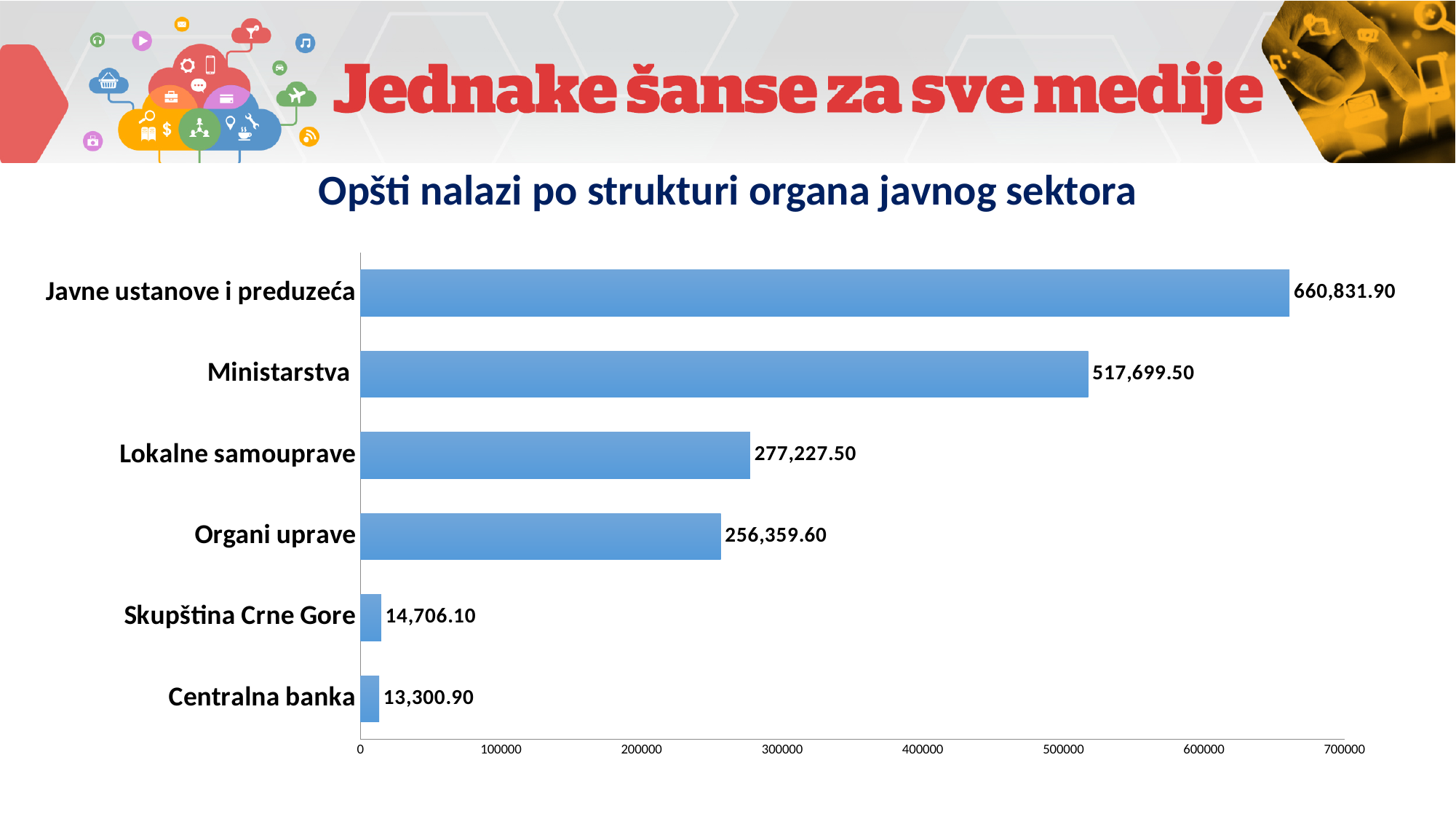
What is the value for Javne ustanove i preduzeća? 660,831.90 What is the value for Ministarstva? 517,699.50 Which has a larger value, Lokalne samouprave or Organi uprave? Lokalne samouprave Which category has the lowest value? Centralna banka What is the value for Centralna banka? 13,300.90 Which category has the highest value? Javne ustanove i preduzeća Is the value for Ministarstva greater or less than 500000? greater What is the difference between the values for Lokalne samouprave and Organi uprave? 20,867.90 How many categories are shown in the chart? 6 What is the value for Skupština Crne Gore? 14,706.10 What is the difference between the values for Javne ustanove i preduzeća and Ministarstva? 143,132.40 What kind of chart is shown on the slide? Bar chart